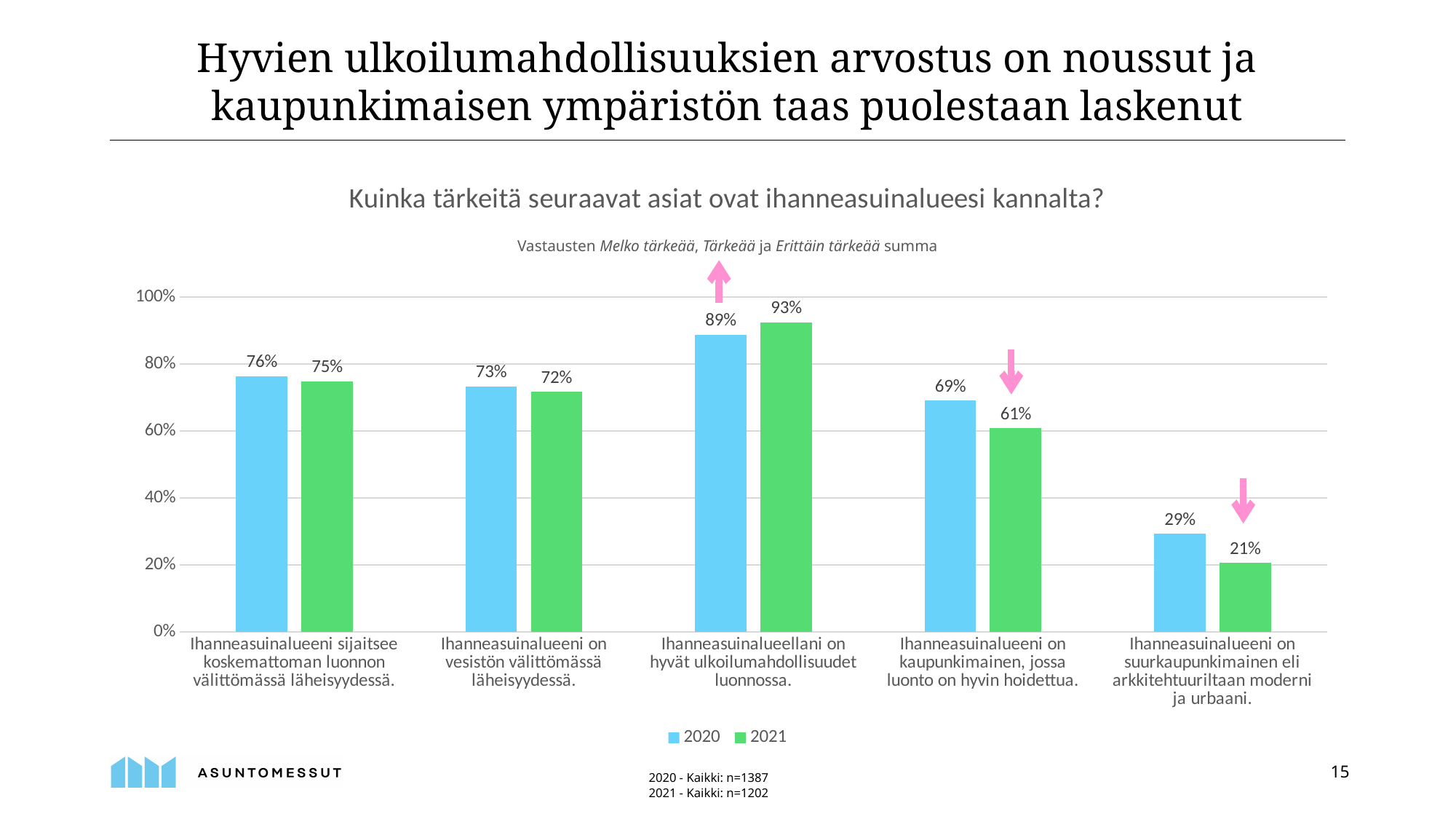
Which series is shown in green? 2021 How many categories are shown on the x axis? 5 What kind of chart is shown on the slide? Bar chart Which category has the lowest 2021 value? Ihanneasuinalueeni on suurkaupunkimainen eli arkkitehtuuriltaan moderni ja urbaani. How many series does the legend list? 2 What is the 2021 value for "Ihanneasuinalueeni on suurkaupunkimainen eli arkkitehtuuriltaan moderni ja urbaani."? 21% For "Ihanneasuinalueeni on suurkaupunkimainen eli arkkitehtuuriltaan moderni ja urbaani.", which year has the larger value, 2020 or 2021? 2020 What is the 2021 value for "Ihanneasuinalueellani on hyvät ulkoilumahdollisuudet luonnossa."? 93% What is the 2020 value for "Ihanneasuinalueeni on kaupunkimainen, jossa luonto on hyvin hoidettua."? 69% What is the sample size (n) for 2021 shown below the chart? n=1202 What is the difference between the 2020 and 2021 values for "Ihanneasuinalueeni on kaupunkimainen, jossa luonto on hyvin hoidettua."? 8 percentage points Which category has the highest 2020 value? Ihanneasuinalueellani on hyvät ulkoilumahdollisuudet luonnossa.